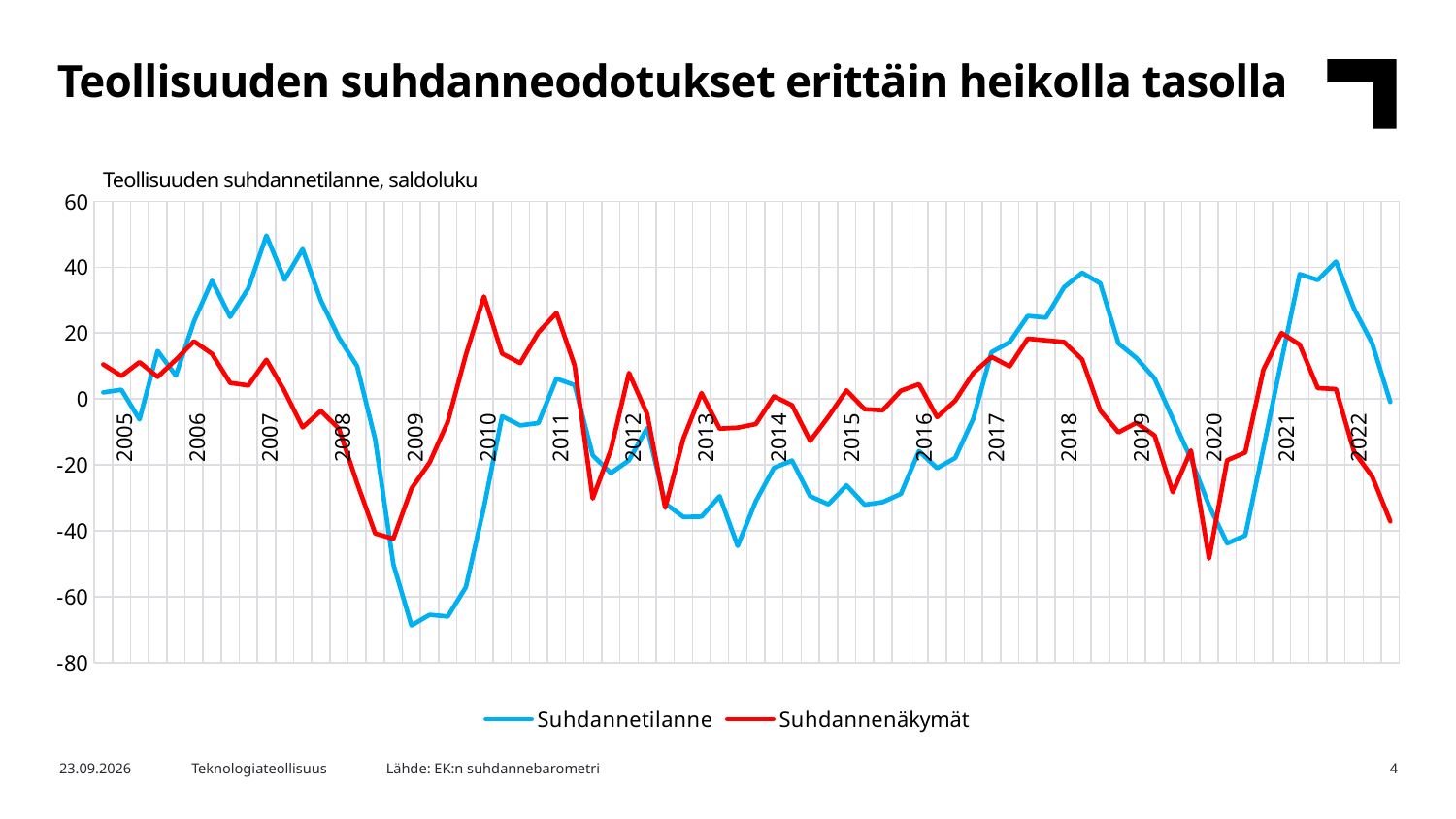
Does the Suhdannenäkymät line rise or fall from its 2021 peak to the end of 2022? fall How many series does the legend list? 2 Is the lowest value of the Suhdannenäkymät line in 2020 greater or less than -40? less What are the two series named in the legend? Suhdannetilanne and Suhdannenäkymät Is the peak of the Suhdannenäkymät line in 2010 greater or less than 20? greater In which year does the Suhdannetilanne line reach its lowest point? 2009 What is the title printed above the chart? Teollisuuden suhdannetilanne, saldoluku Is the lowest value of the Suhdannetilanne line in 2009 greater or less than -60? less In 2009, which series is lower, Suhdannetilanne or Suhdannenäkymät? Suhdannetilanne What kind of chart is shown on the slide? line chart